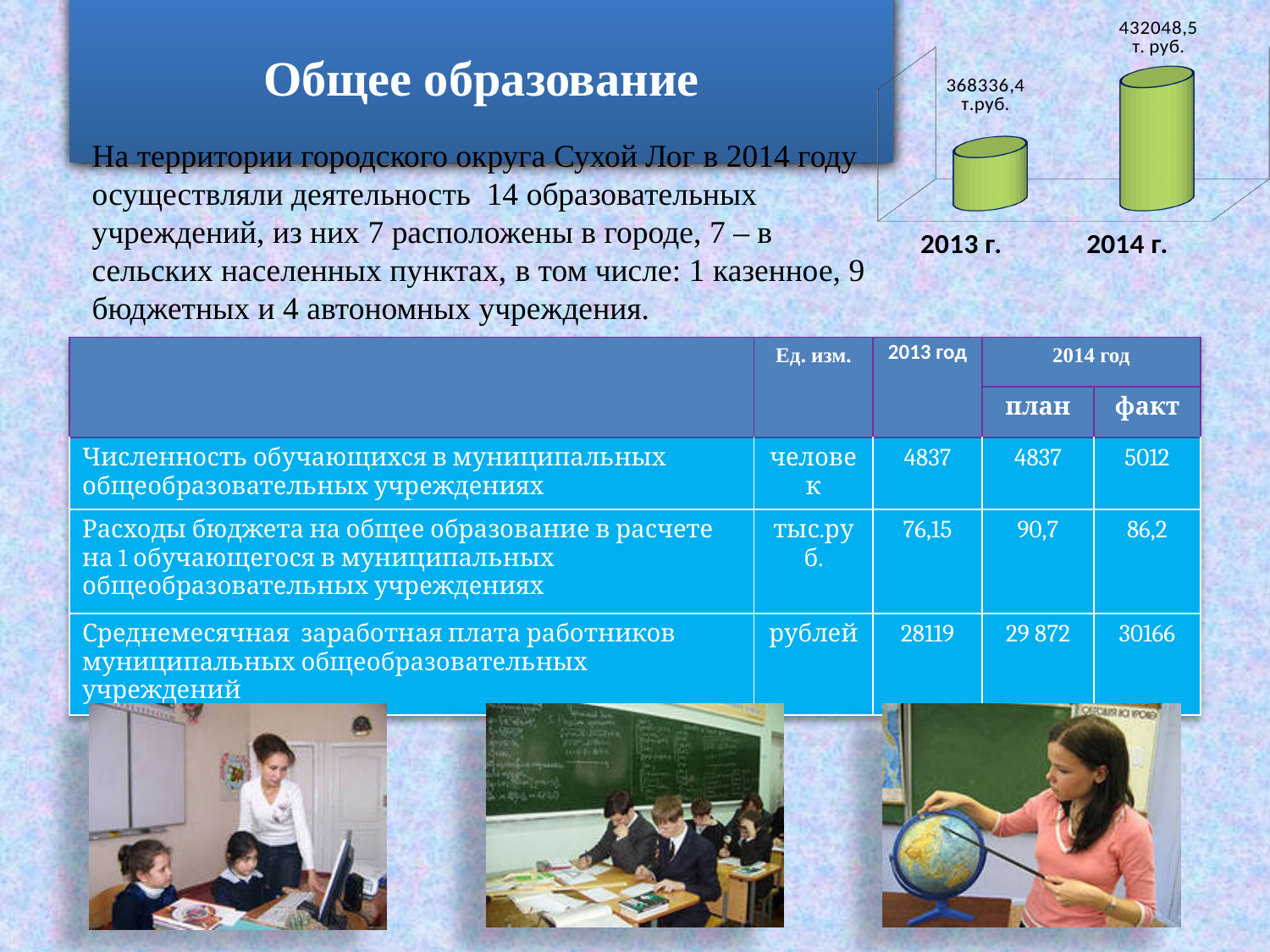
How many categories (years) are plotted in the chart? 2 What kind of chart is shown in the top right of the slide? bar chart What is the value shown for 2013 г. in the chart? 368336,4 т.руб. By how much does the 2014 г. value exceed the 2013 г. value in the chart? 63712,1 Which year has the lower value in the chart? 2013 г. Do the values in the chart rise or fall from 2013 г. to 2014 г.? rise Which year has the higher value in the chart? 2014 г. What unit is shown on the data labels of the chart? т. руб. What colour are the bars in the chart? green Is the value for 2013 г. larger or smaller than the value for 2014 г.? smaller What is the value shown for 2014 г. in the chart? 432048,5 т. руб.